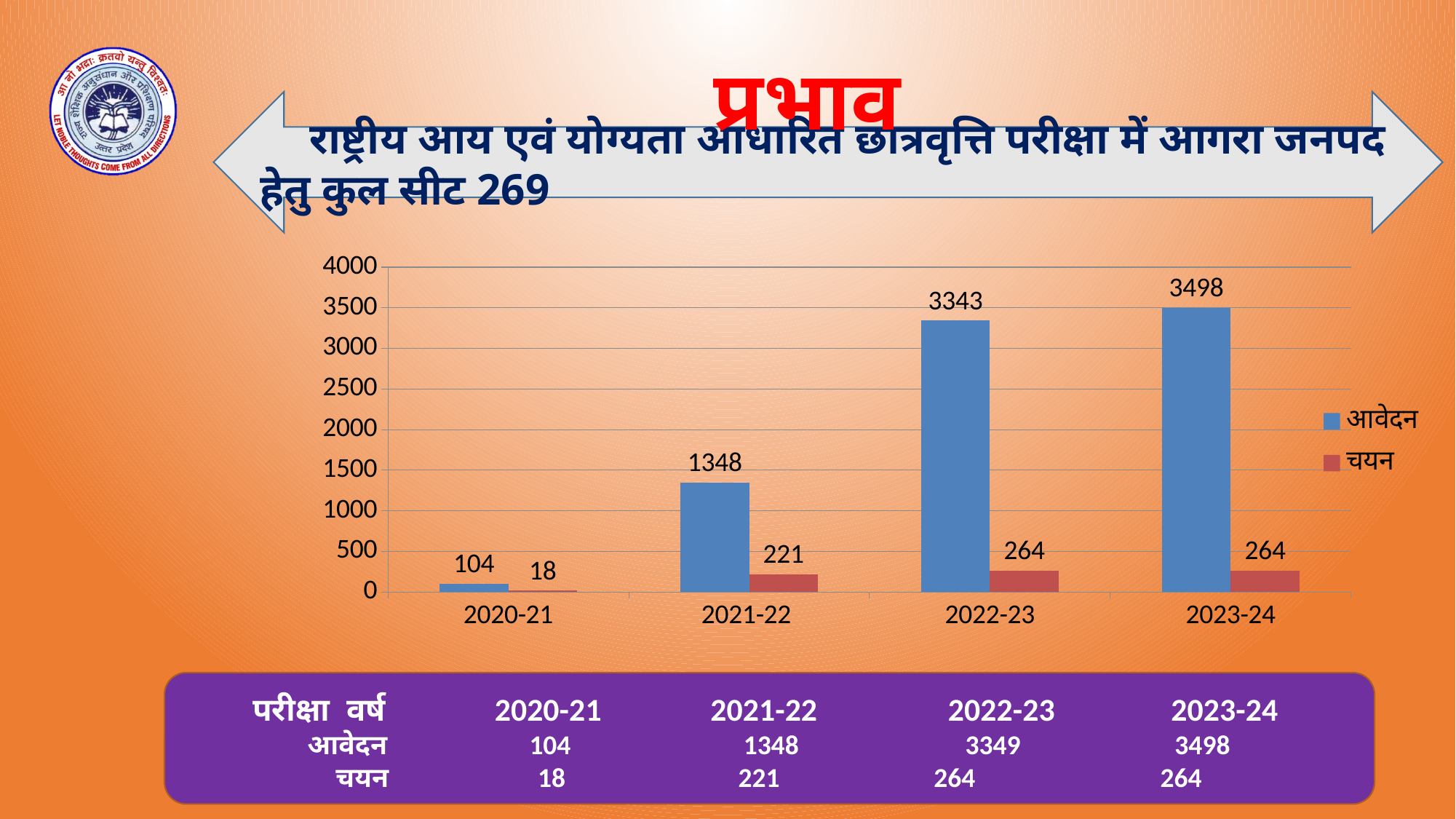
What is the value of आवेदन for 2020-21? 104 Which year has the highest आवेदन value? 2023-24 How many years are shown on the x axis of the chart? 4 Is the आवेदन value for 2021-22 greater or less than 1000? greater What is the difference between आवेदन and चयन in 2021-22? 1127 What kind of chart is shown on the slide? bar chart Which is larger, आवेदन in 2021-22 or आवेदन in 2023-24? आवेदन in 2023-24 How many series does the legend list? 2 What is the value of आवेदन for 2023-24? 3498 What is the value of चयन for 2020-21? 18 Which year has the lowest चयन value? 2020-21 What is the value of चयन for 2021-22? 221